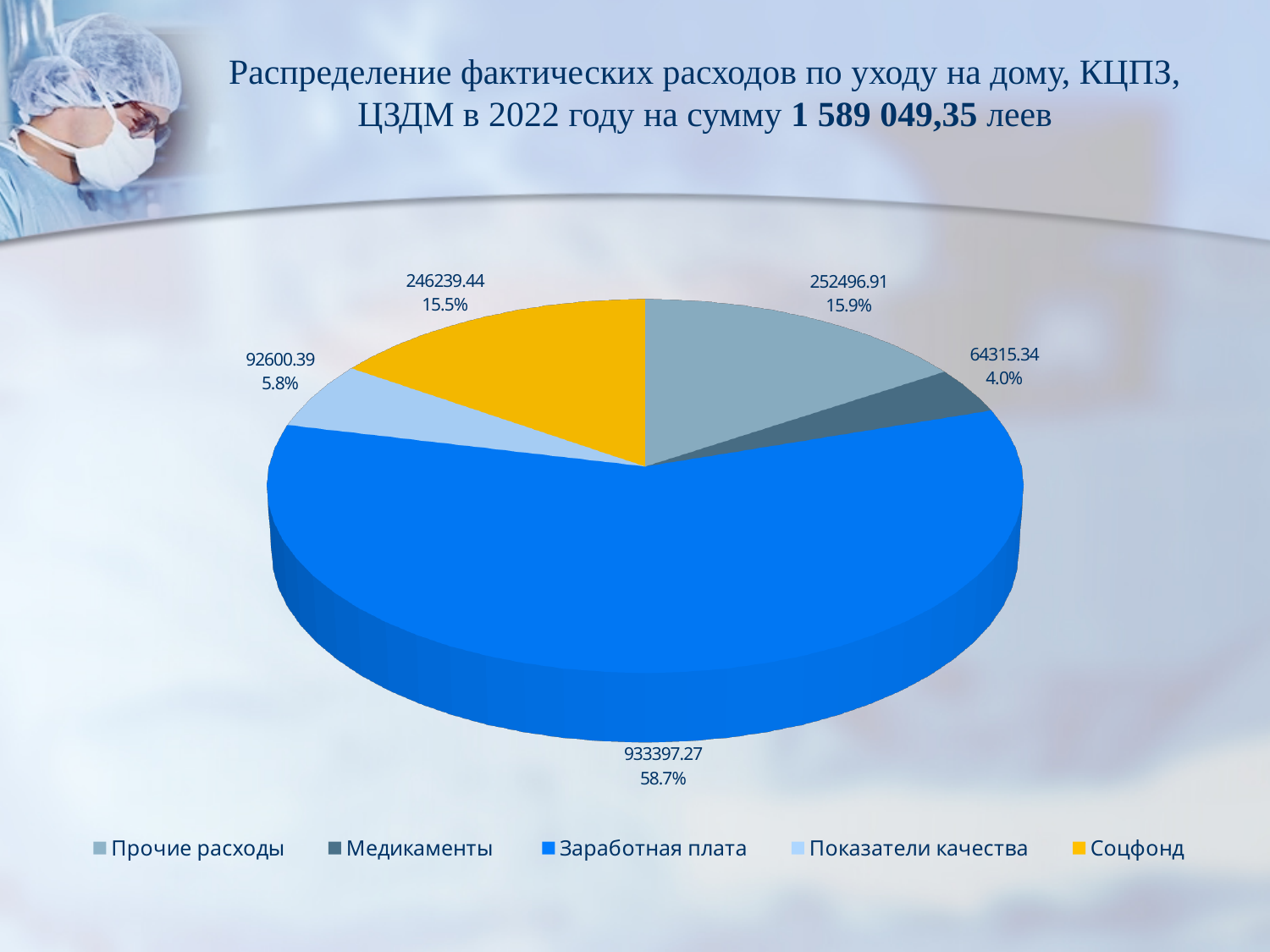
What is the value for Заработная плата? 933397.27 What share of the pie does Соцфонд represent? 15.5% What kind of chart is shown on the slide? pie chart How many slices does the pie chart have? 5 What is the value for Медикаменты? 64315.34 What is the difference between the values for Прочие расходы and Соцфонд? 6257.47 Which colour represents Соцфонд in the pie chart? yellow Which category has the smallest slice? Медикаменты What is the value for Показатели качества? 92600.39 Which category has the largest slice? Заработная плата What share of the pie does Заработная плата represent? 58.7% How many entries does the legend list? 5